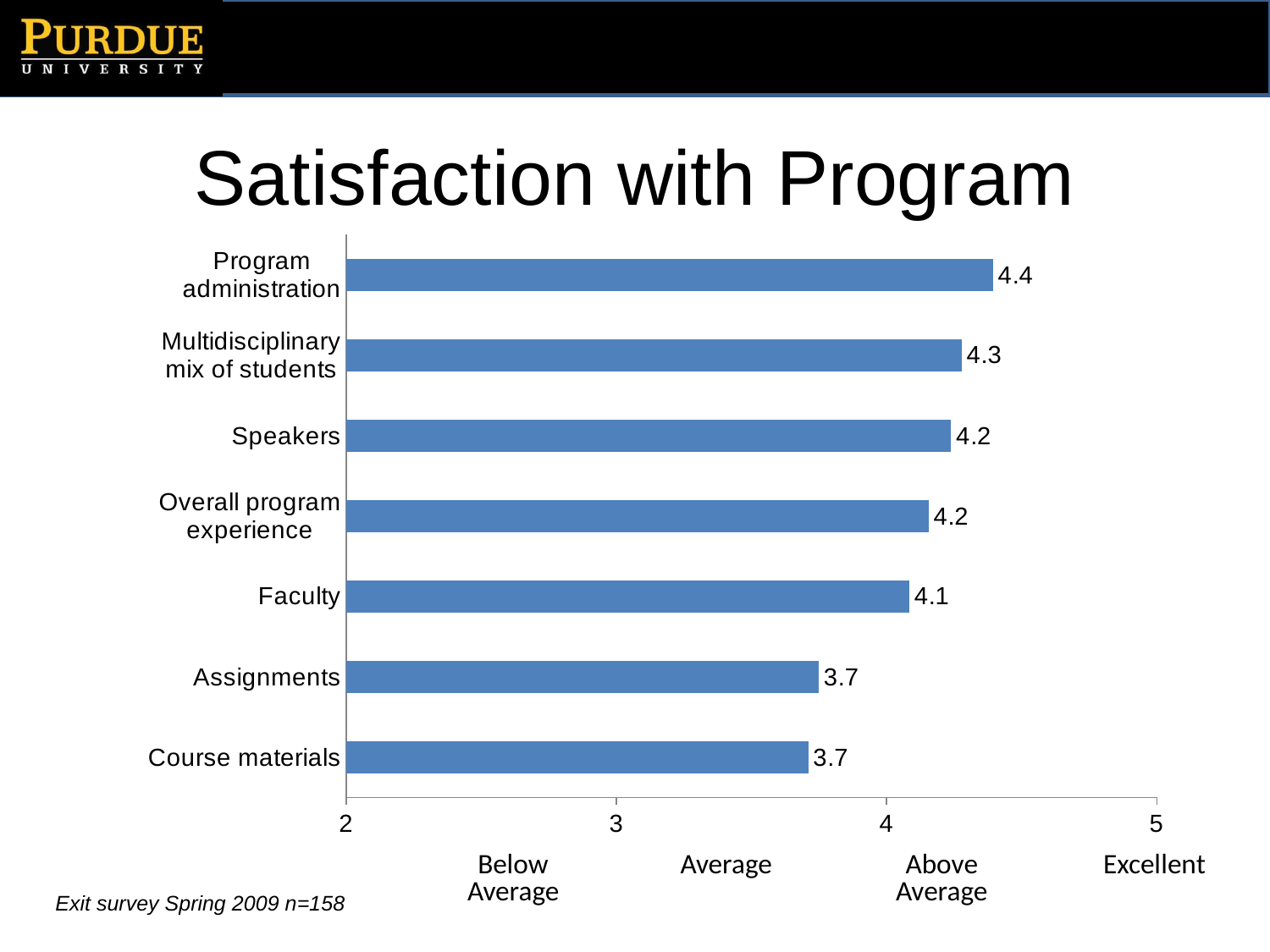
What is the satisfaction value for Program administration? 4.4 What is the difference between the values for Program administration and Assignments? 0.7 Which is larger, the value for Speakers or the value for Faculty? Speakers What is the satisfaction value for Faculty? 4.1 What is the title of the chart? Satisfaction with Program What kind of chart is shown on the slide? bar chart What is the satisfaction value for Multidisciplinary mix of students? 4.3 How many categories are shown in the chart? 7 What is the satisfaction value for Course materials? 3.7 Which category has the highest satisfaction value? Program administration What label on the x axis corresponds to the value 5? Excellent Is the value for Assignments greater or less than 4? less